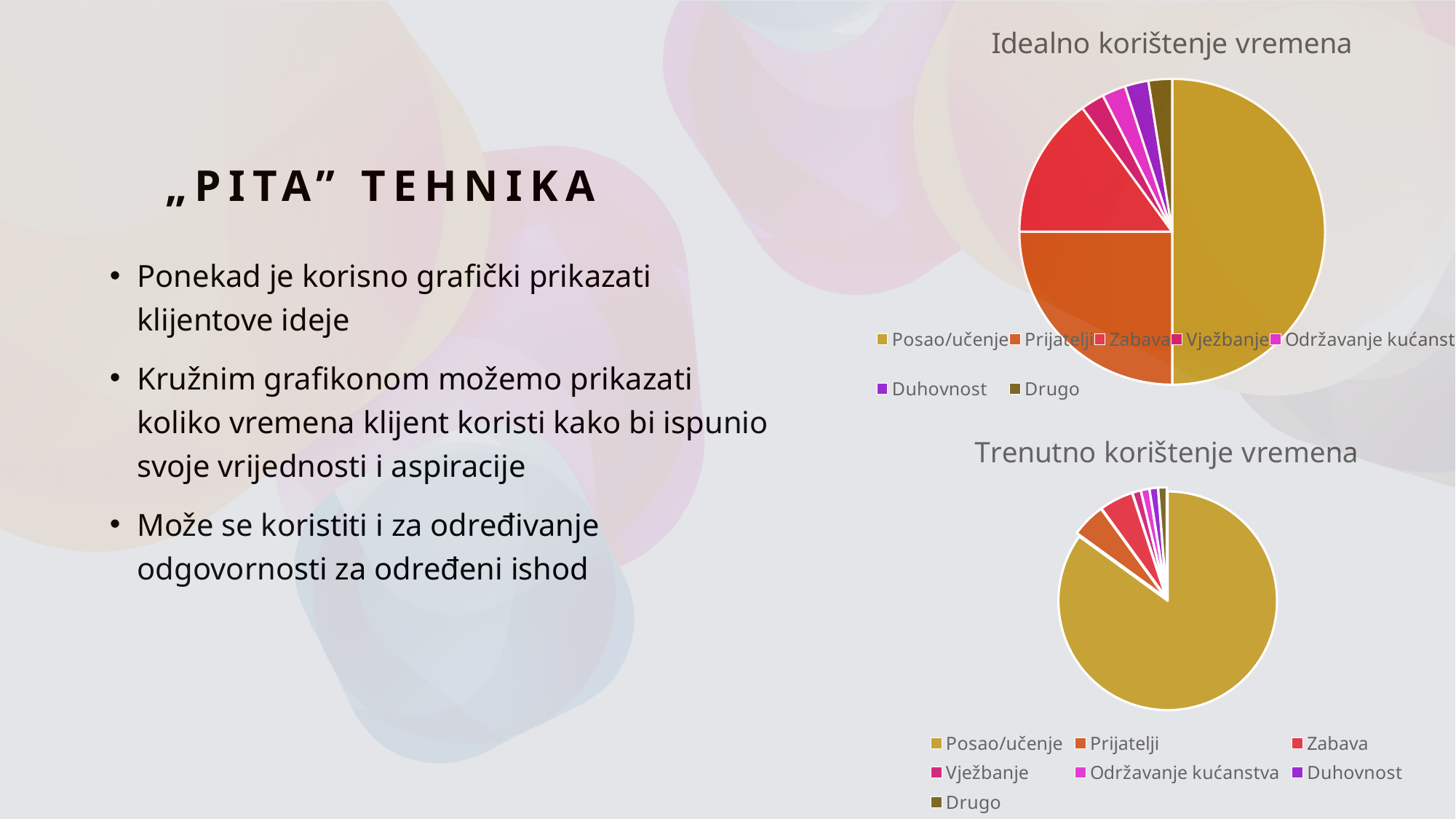
In the "Idealno korištenje vremena" chart, which slice is larger: Zabava or Duhovnost? Zabava In the "Idealno korištenje vremena" chart, which category has the largest slice? Posao/učenje What kind of chart is the "Idealno korištenje vremena" chart? pie chart In the "Idealno korištenje vremena" chart, how many categories does the legend list? 7 What is the title of the upper pie chart on the slide? Idealno korištenje vremena In the "Trenutno korištenje vremena" chart, which slice is larger: Posao/učenje or Prijatelji? Posao/učenje In the "Trenutno korištenje vremena" chart, how many slices are there? 7 In the "Trenutno korištenje vremena" chart, which category has the largest slice? Posao/učenje In the "Idealno korištenje vremena" chart, which slice is larger: Prijatelji or Zabava? Prijatelji In the "Trenutno korištenje vremena" chart, which category is shown in the gold/yellow colour? Posao/učenje What kind of chart is the "Trenutno korištenje vremena" chart? pie chart